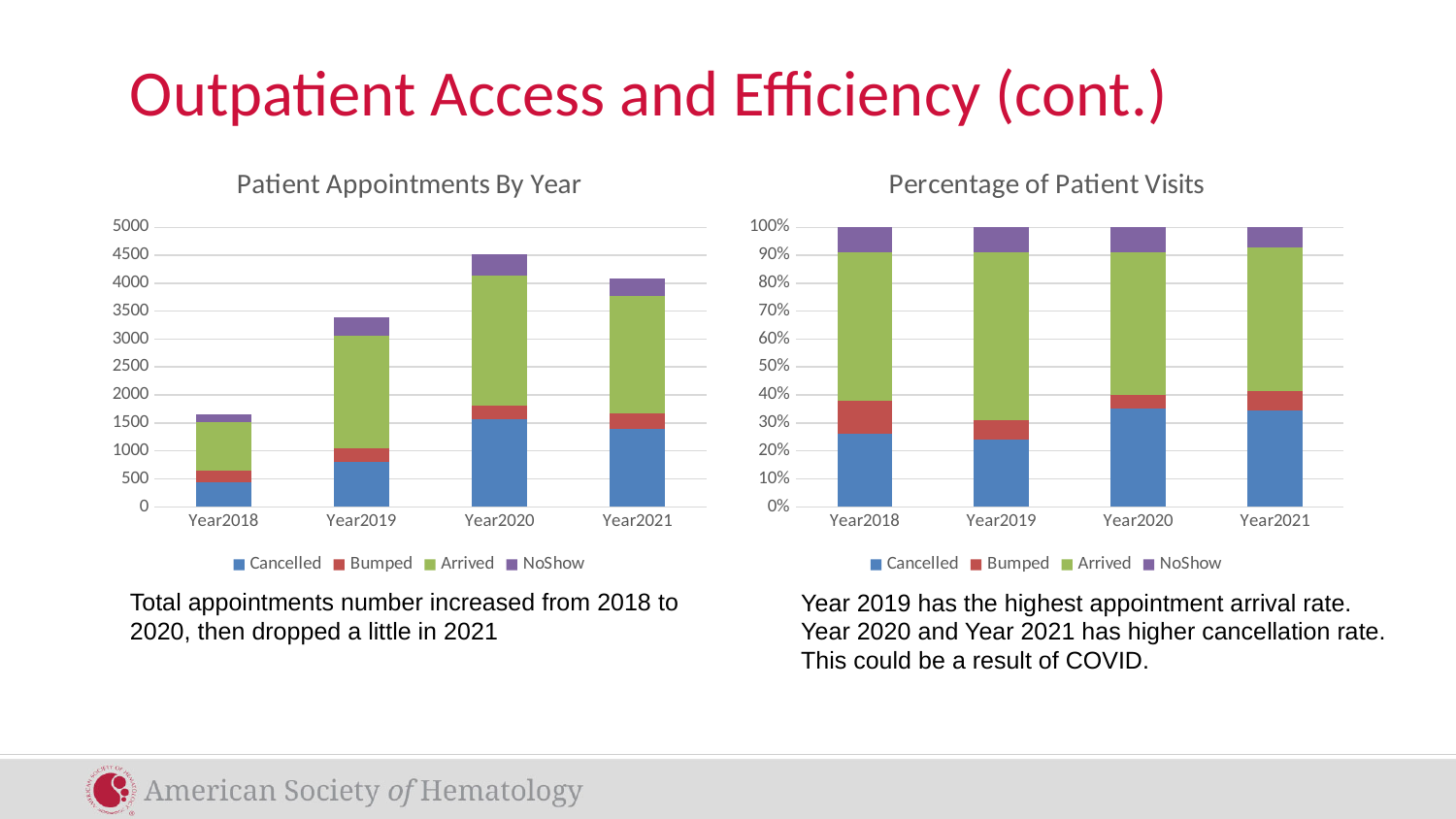
In the "Percentage of Patient Visits" chart, is the Cancelled share for Year2019 greater or less than 30%? less How many series does the legend of the "Patient Appointments By Year" chart list? 4 In the "Patient Appointments By Year" chart, is the total for Year2020 greater or less than 4000? greater In the "Patient Appointments By Year" chart, is the total for Year2018 greater or less than 2000? less In the "Percentage of Patient Visits" chart, which year has the largest Arrived share? Year2019 In the "Patient Appointments By Year" chart, which year has the lowest total number of appointments? Year2018 In the "Patient Appointments By Year" chart, which year has the highest total number of appointments? Year2020 In the "Patient Appointments By Year" chart, which year has a larger total, Year2020 or Year2021? Year2020 Which colour represents the Arrived series in the legend of the "Percentage of Patient Visits" chart? Green What type of chart is the "Patient Appointments By Year" chart on the left? Stacked bar chart How many years are shown on the x axis of the "Percentage of Patient Visits" chart? 4